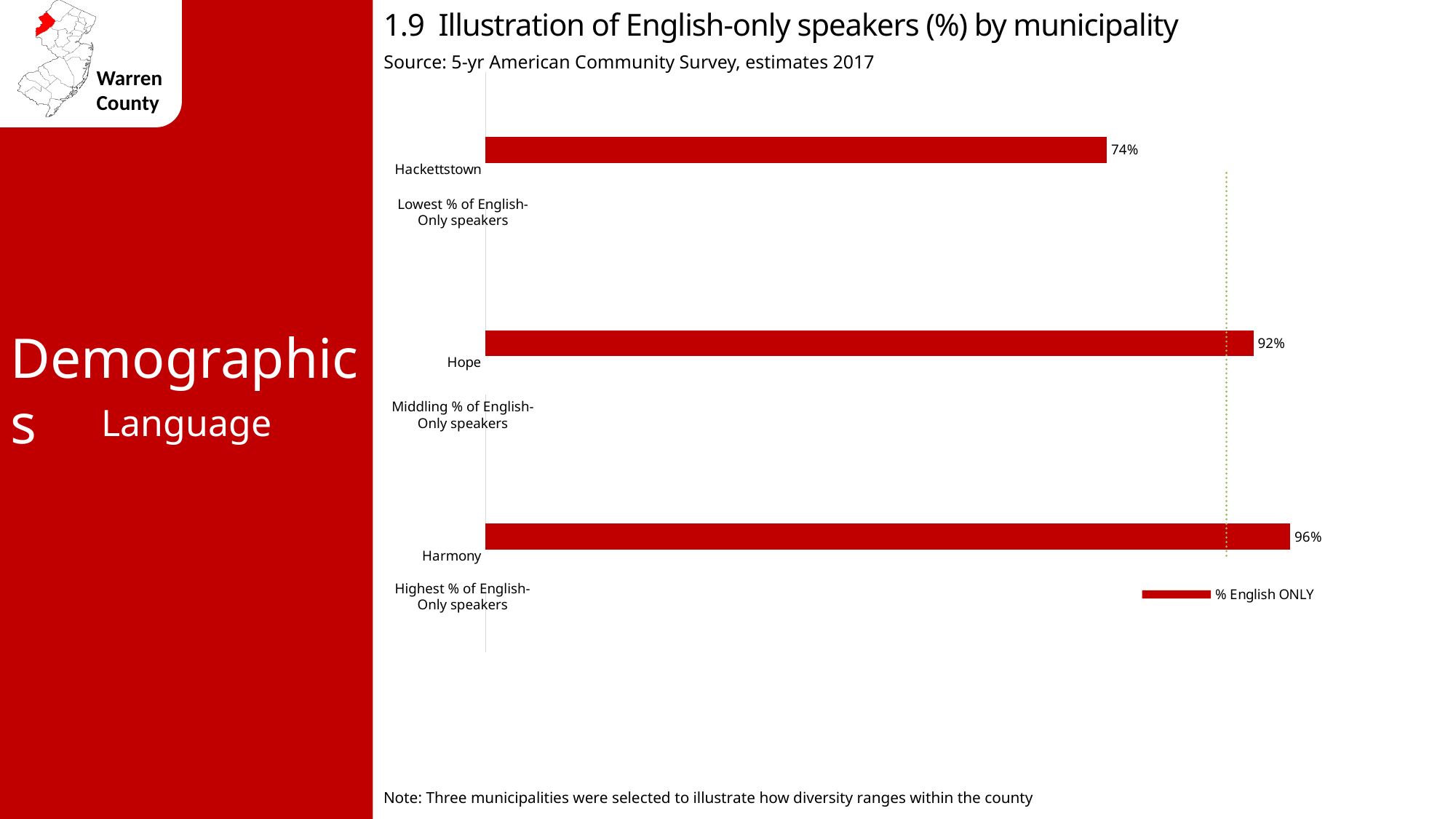
Which municipality has the highest percentage of English-only speakers? Harmony What is the percentage of English-only speakers in Hope? 92% How many municipalities are shown in the chart? 3 What is the difference in percentage points between Hope and Hackettstown? 18 What type of chart is shown on the slide? Bar chart What is the percentage of English-only speakers in Harmony? 96% Which has a higher percentage of English-only speakers, Hope or Hackettstown? Hope What is the difference in percentage points between Harmony and Hackettstown? 22 What is the percentage of English-only speakers in Hackettstown? 74% How many series does the legend list? 1 Which municipality has the lowest percentage of English-only speakers? Hackettstown What is the legend entry for the series in the chart? % English ONLY